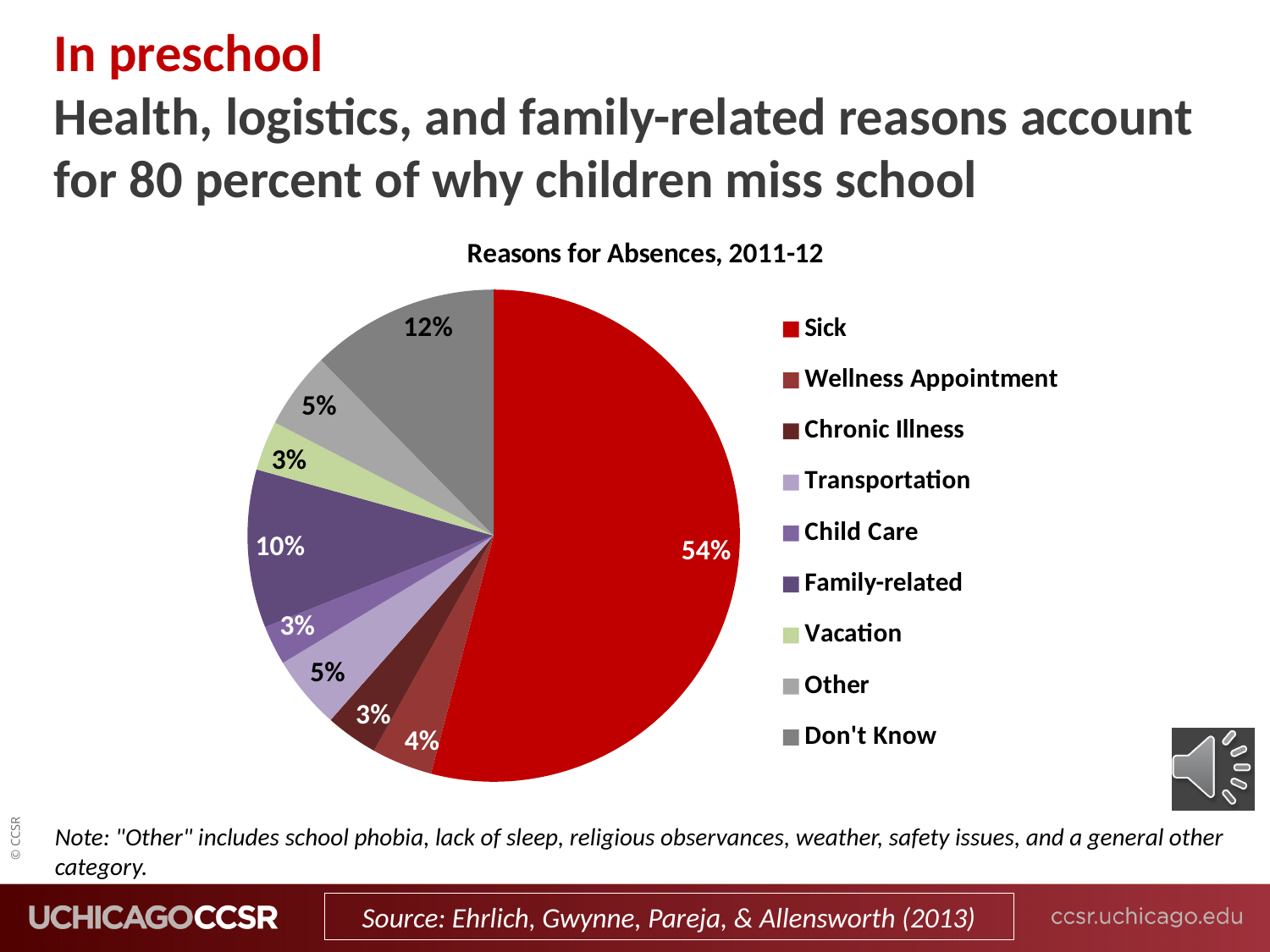
What is the difference between the share for Sick and the share for Don't Know? 42% How many categories does the legend list? 9 What is the title of the chart? Reasons for Absences, 2011-12 What share of absences is attributed to Wellness Appointment? 4% What share of absences is attributed to Transportation? 5% Which reason accounts for the largest share of absences? Sick What share of absences is attributed to Don't Know? 12% What is the combined share of Transportation and Child Care? 8% What share of absences is attributed to Sick? 54% What share of absences is attributed to Family-related reasons? 10% Which is larger, the share for Family-related or the share for Other? Family-related What kind of chart is shown on the slide? pie chart